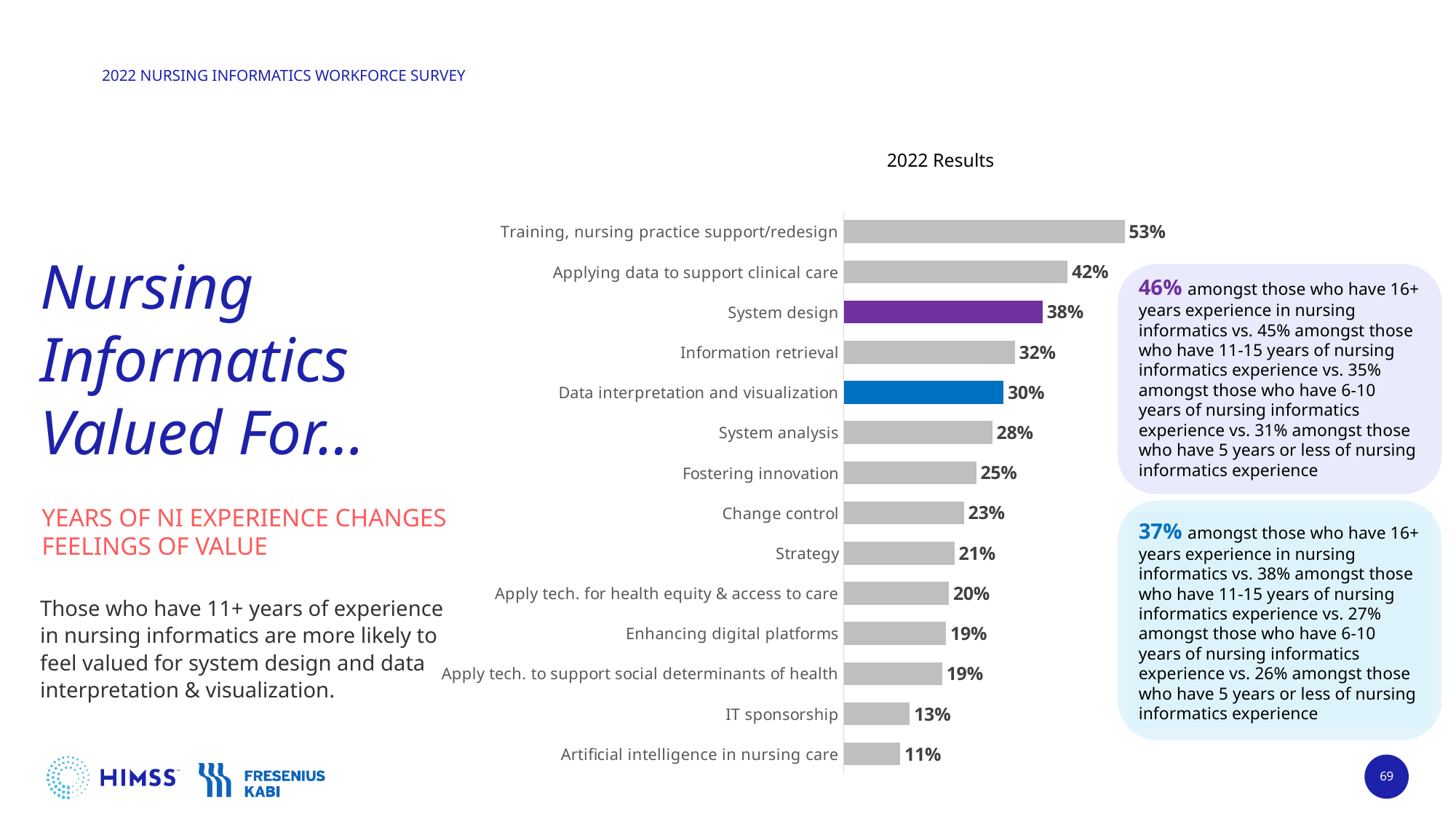
Which category has the highest value in the chart? Training, nursing practice support/redesign What is the title of the chart? 2022 Results What is the difference between the values for Change control and Strategy? 2% Which category's bar is coloured purple? System design What kind of chart is shown on the slide? Bar chart What is the value for Data interpretation and visualization? 30% Which is larger, the value for Information retrieval or the value for System analysis? Information retrieval Which category has the lowest value in the chart? Artificial intelligence in nursing care What percentage is shown for IT sponsorship? 13% What percentage is shown for System design? 38% What is the difference between the values for Training, nursing practice support/redesign and Applying data to support clinical care? 11% How many categories are shown in the chart? 14